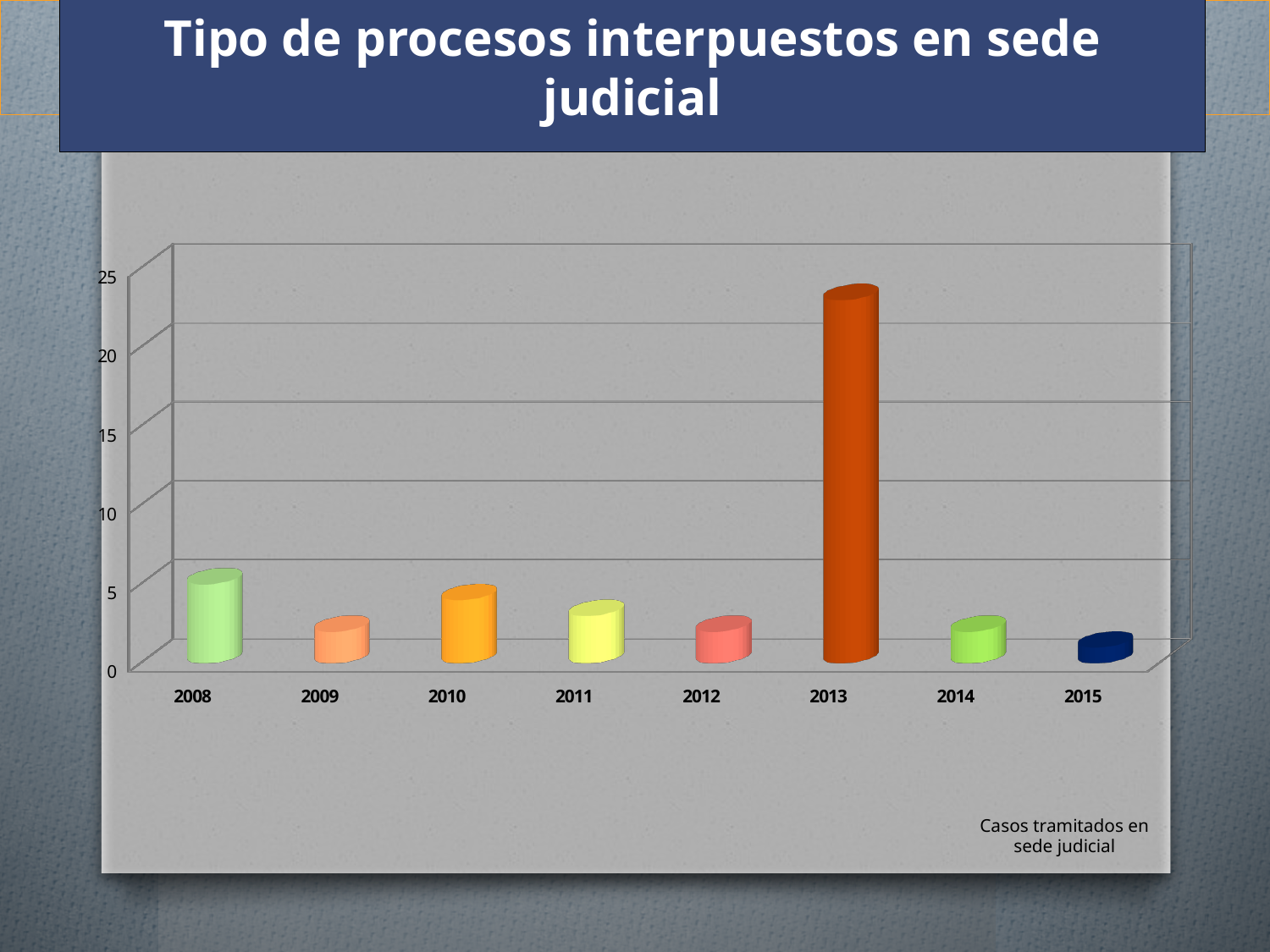
What is the title of the chart on the slide? Tipo de procesos interpuestos en sede judicial What kind of chart is shown on the slide? bar chart Is the value for 2013 greater or less than 10? greater Is the value for 2009 greater or less than 5? less Which is larger, the value for 2008 or the value for 2009? 2008 Which year has the highest value in the chart? 2013 Which year has the lowest value in the chart? 2015 Which is larger, the value for 2013 or the value for 2014? 2013 Is the value for 2015 greater or less than 5? less How many years (categories) are shown on the x axis of the chart? 8